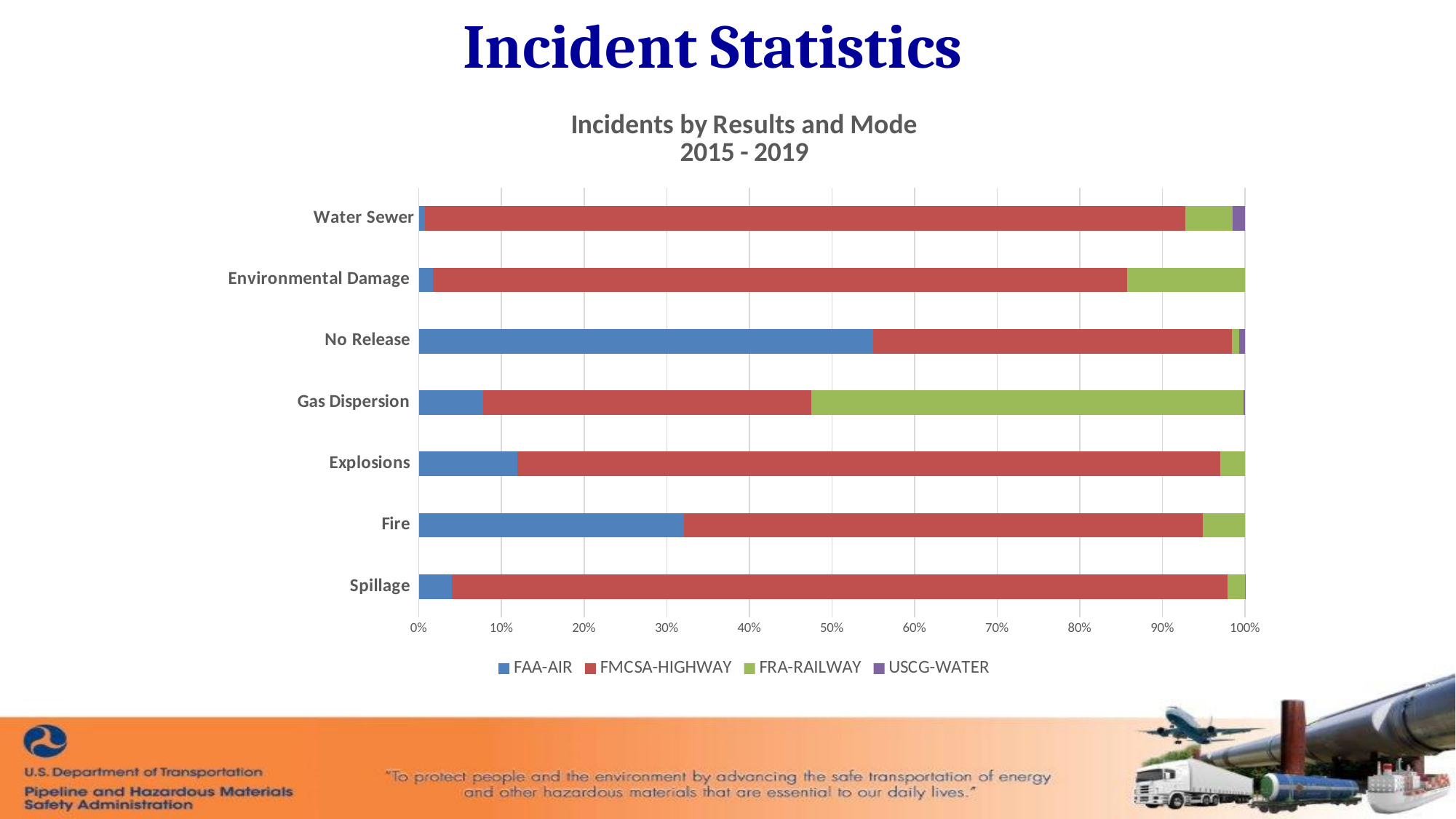
What is the title of the chart? Incidents by Results and Mode 2015 - 2019 Which category has the largest FRA-RAILWAY share? Gas Dispersion Which series is shown in red in the chart? FMCSA-HIGHWAY Which has the larger FAA-AIR share, Fire or Explosions? Fire Is the FAA-AIR share for Spillage greater or less than 10%? less What kind of chart is shown on the slide? Bar chart Which category has the largest FAA-AIR share? No Release Is the FRA-RAILWAY share for Gas Dispersion greater or less than 50%? greater How many incident result categories are shown on the y axis of the chart? 7 Is the FAA-AIR share for No Release greater or less than 50%? greater How many series does the chart legend list? 4